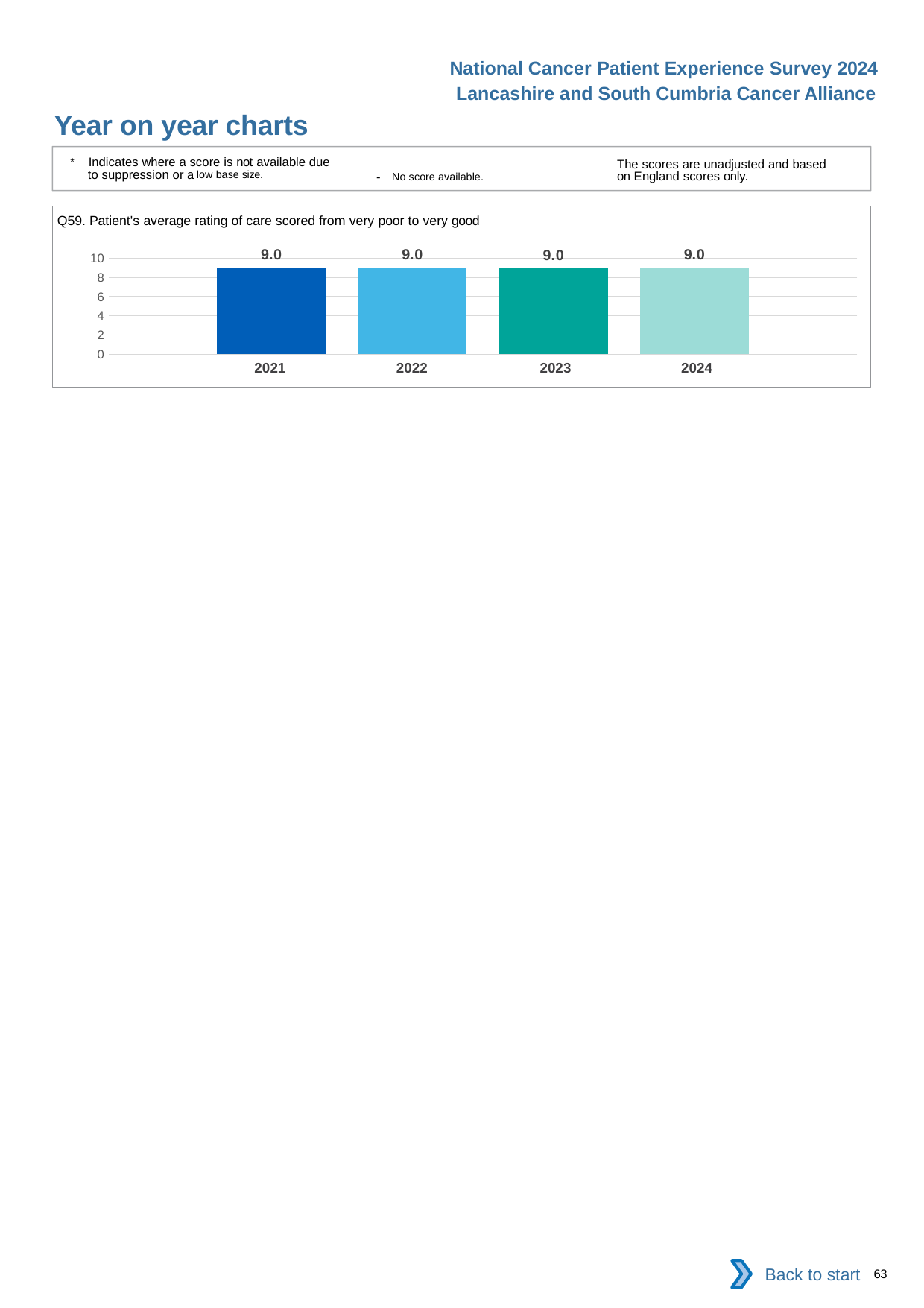
Do the values rise, fall or stay the same from 2021 to 2024? stay the same What is the title of the chart? Q59. Patient's average rating of care scored from very poor to very good What is the value for 2024? 9.0 How many years are shown on the x axis? 4 Is the value for 2023 greater or less than 8? greater What is the value for 2023? 9.0 What is the highest value shown on the y axis? 10 What is the difference between the values for 2024 and 2021? 0.0 What is the value for 2022? 9.0 What is the value for 2021? 9.0 What kind of chart is this? bar chart Is the value for 2021 greater or less than 10? less